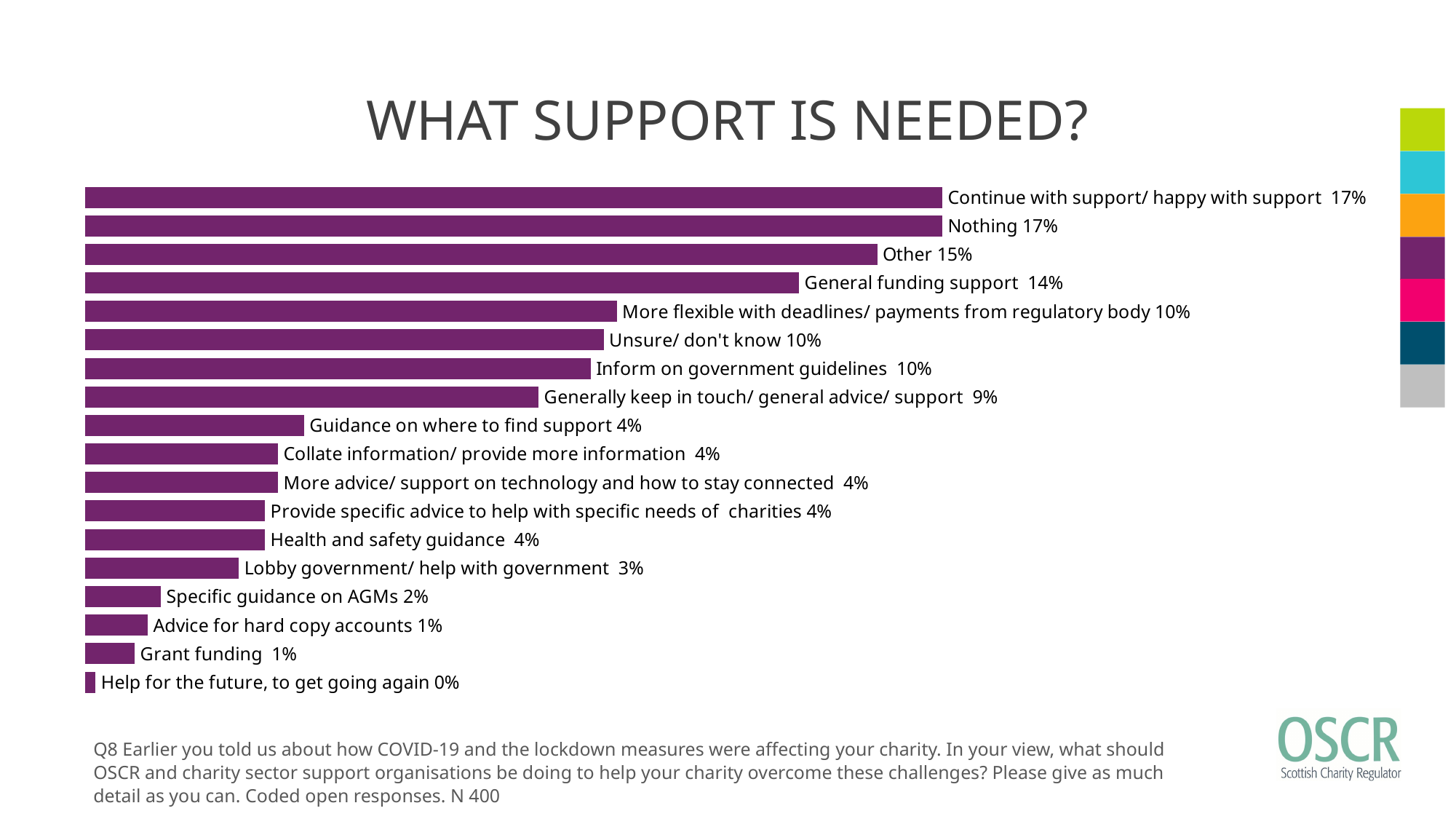
How many categories are shown on the chart? 18 What percentage is shown for Specific guidance on AGMs? 2% What value is shown for Lobby government/ help with government? 3% What percentage is shown for General funding support? 14% What type of chart is shown on the slide? Bar chart What is the title of the slide? WHAT SUPPORT IS NEEDED? What is the difference between the values for Other and General funding support? 1% Which is larger, the value for Health and safety guidance or the value for Grant funding? Health and safety guidance What is the difference between the values for Nothing and Unsure/ don't know? 7% What value is shown for Generally keep in touch/ general advice/ support? 9% Which is larger, the value for Other or the value for Inform on government guidelines? Other Which category has the lowest value on the chart? Help for the future, to get going again